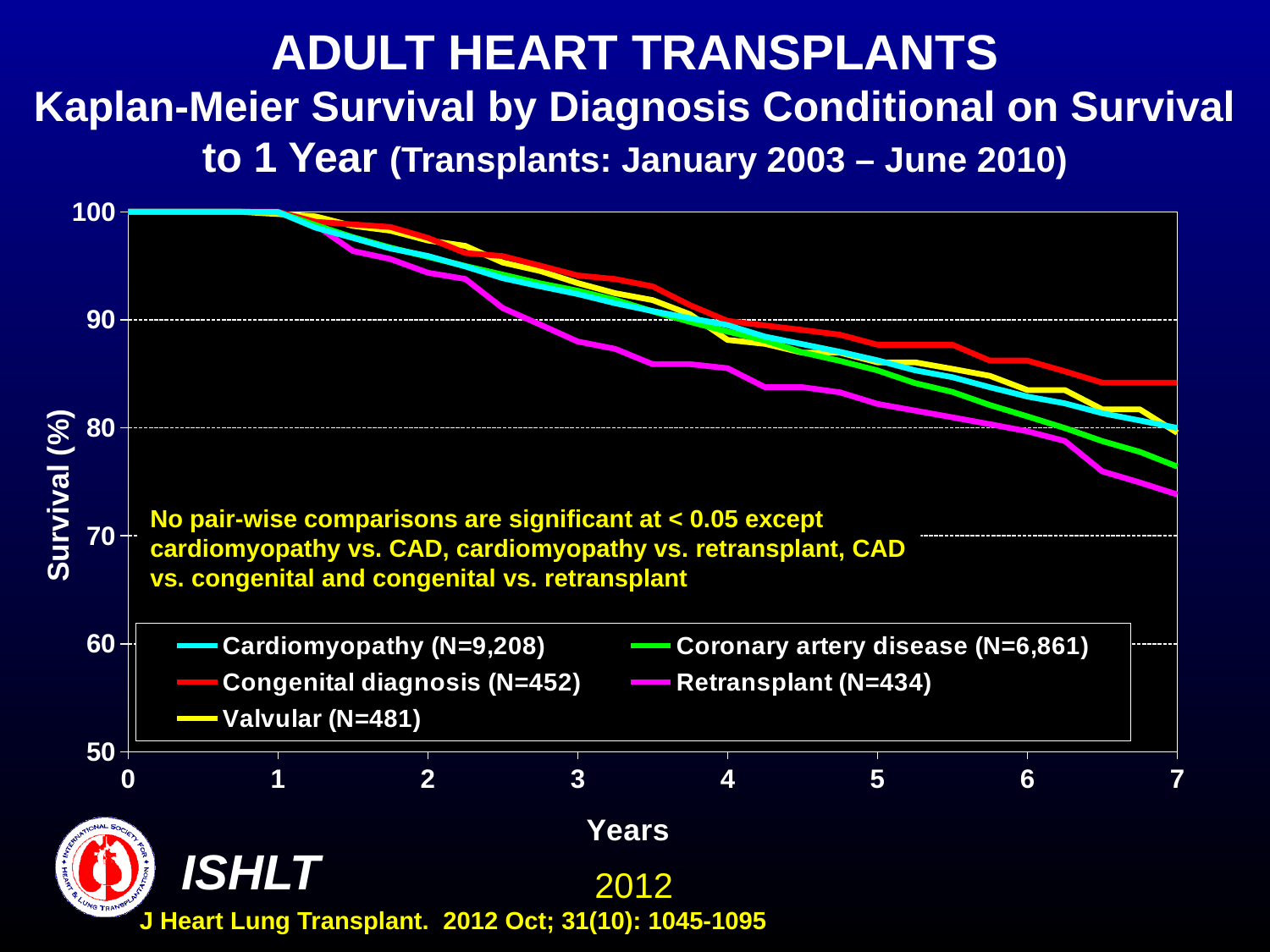
Is the survival value for Congenital diagnosis at year 7 greater or less than 80? greater Which diagnosis group has the lowest survival at year 7? Retransplant Do the survival curves rise or fall as the years increase along the x axis? Fall What kind of chart is shown on the slide? Line chart Is the survival value for Retransplant at year 3 greater or less than 90? less How many series does the legend list? 5 According to the legend, what is the N for the Cardiomyopathy group? N=9,208 Is the survival value for Retransplant at year 7 greater or less than 80? less At year 3, which has higher survival: Congenital diagnosis or Retransplant? Congenital diagnosis Which diagnosis group has the highest survival at year 7? Congenital diagnosis